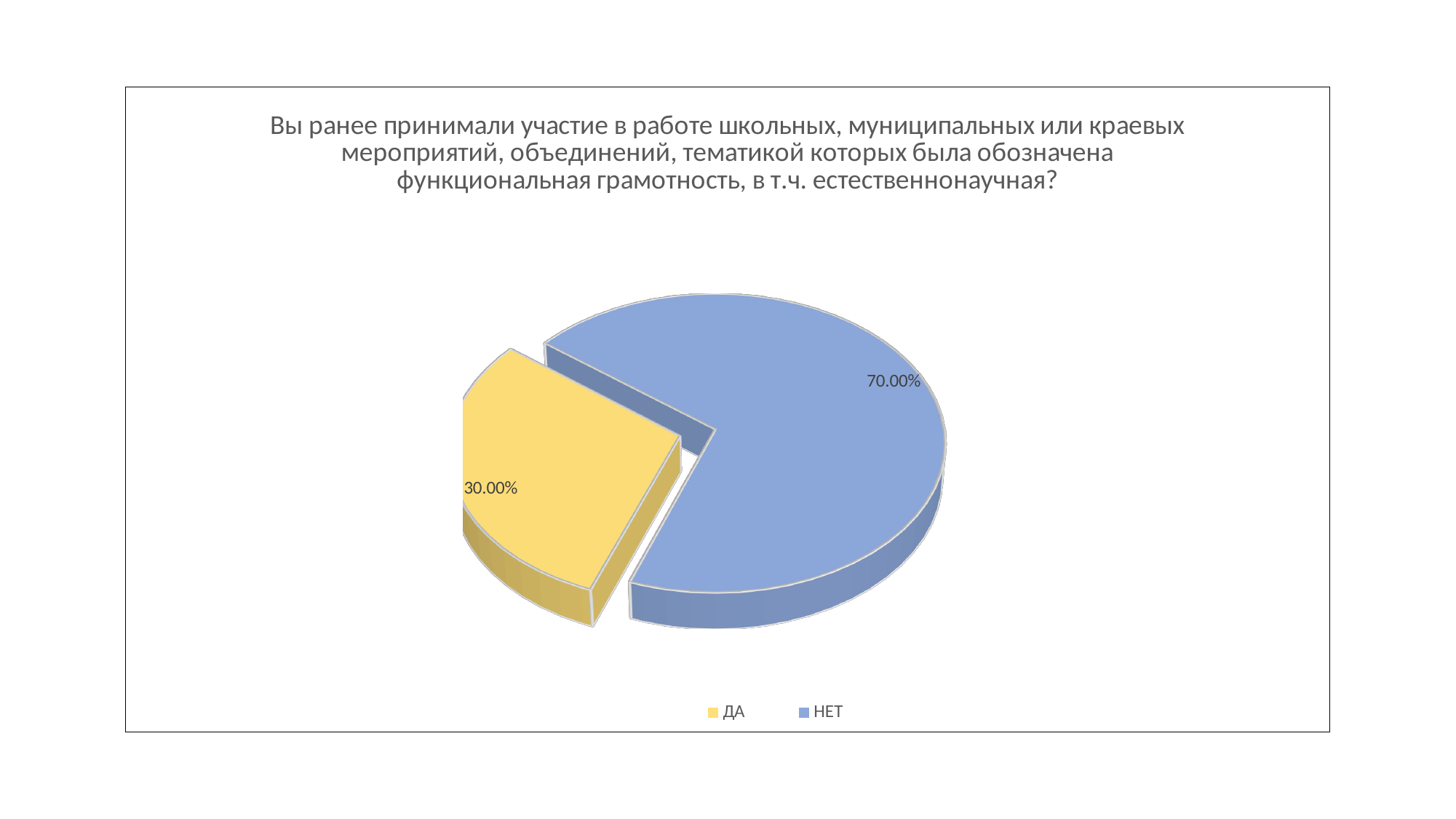
Which is larger, the ДА slice or the НЕТ slice? НЕТ What share of the pie does the НЕТ slice represent? 70.00% What is the difference in percentage points between the НЕТ slice and the ДА slice? 40.00% What share of the pie does the ДА slice represent? 30.00% Which slice is the smallest in the pie chart? ДА What colour is the НЕТ slice? blue How many slices does the pie chart have? 2 What kind of chart is shown on the slide? pie chart Which slice is the largest in the pie chart? НЕТ How many entries does the legend list? 2 What colour is the ДА slice? yellow